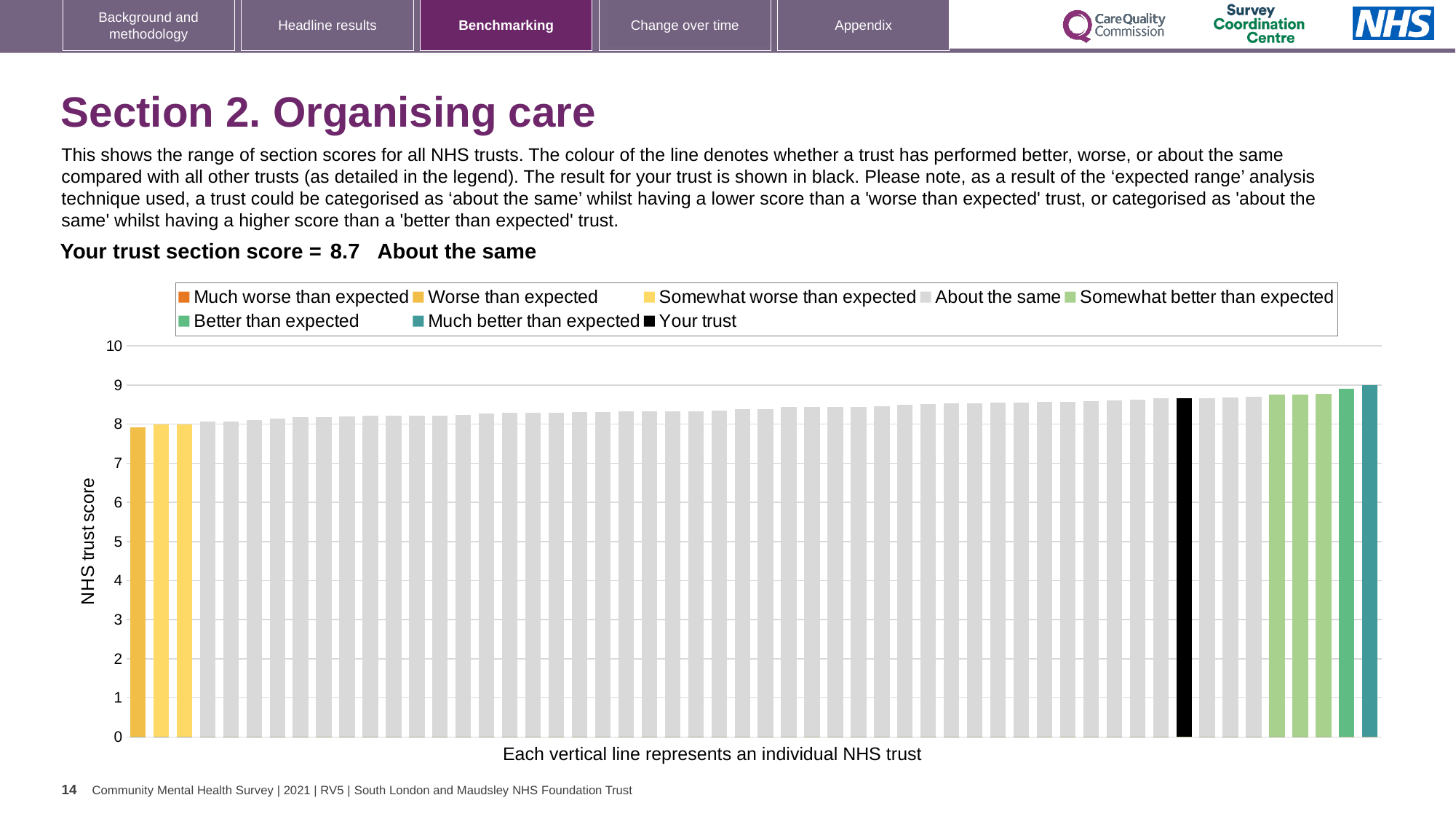
What is the section score for your trust shown on the slide? 8.7 What colour is used for the bar representing your trust? Black Is the value of the black bar (your trust) greater or less than 8? greater Is the value of the leftmost bar greater or less than 7? greater Do the bar values rise or fall from left to right along the x axis? rise Is the value of the tallest bar greater or less than 10? less What kind of chart is shown on the slide? Bar chart Which category is your trust's section score placed in? About the same What is the label on the vertical axis of the chart? NHS trust score Which legend category does the tallest (rightmost) bar belong to? Much better than expected How many entries does the chart legend list? 8